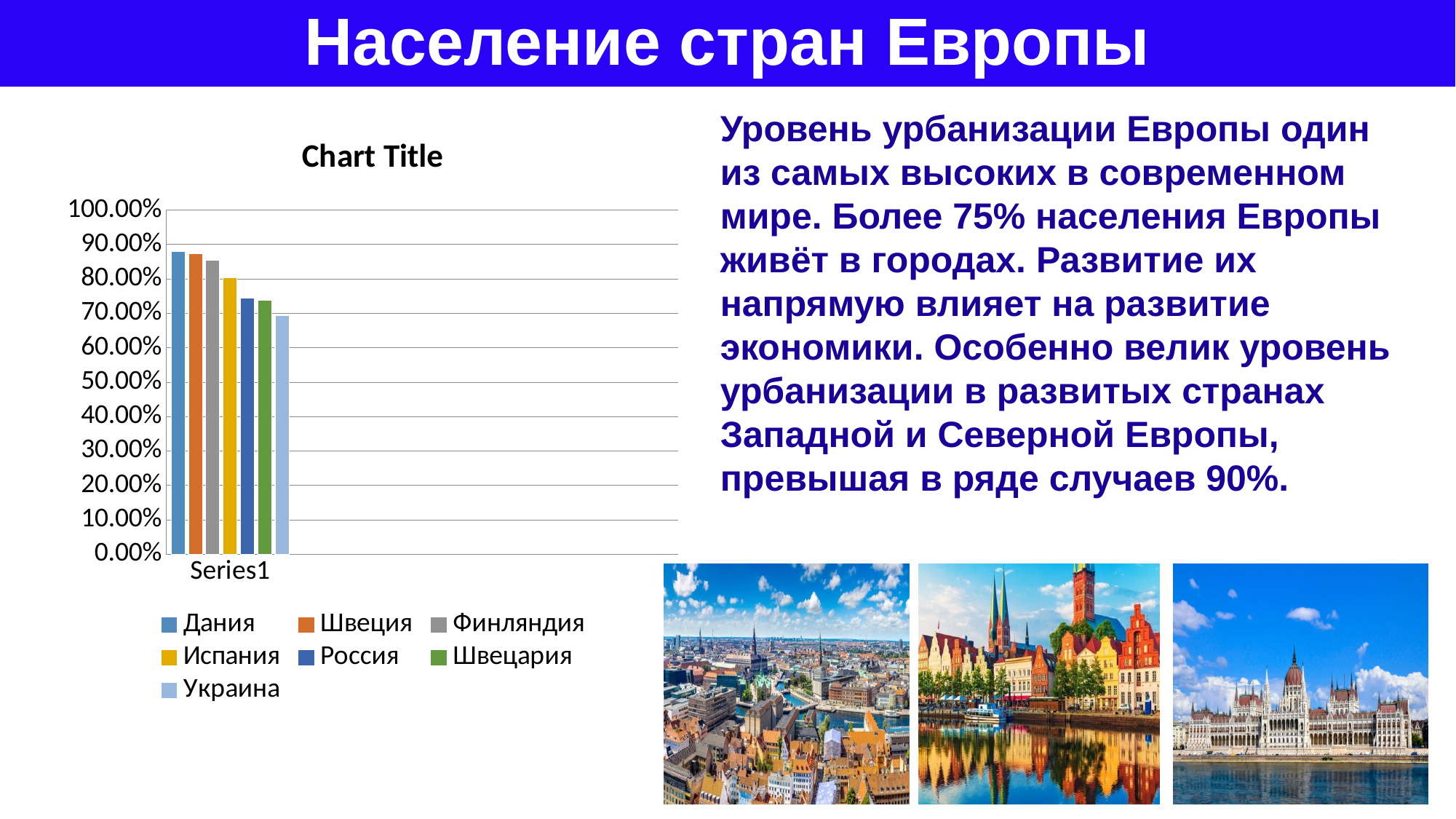
Is the value for Россия greater or less than 80.00%? less Which is larger, the value for Финляндия or the value for Украина? Финляндия What kind of chart is shown on the slide? bar chart Is the value for Финляндия greater or less than 80.00%? greater Which series has the lowest value in the chart? Украина Is the value for Дания greater or less than 80.00%? greater What is the title shown above the chart? Chart Title Which is larger, the value for Испания or the value for Россия? Испания How many series does the chart legend list? 7 What label appears on the x axis under the bars? Series1